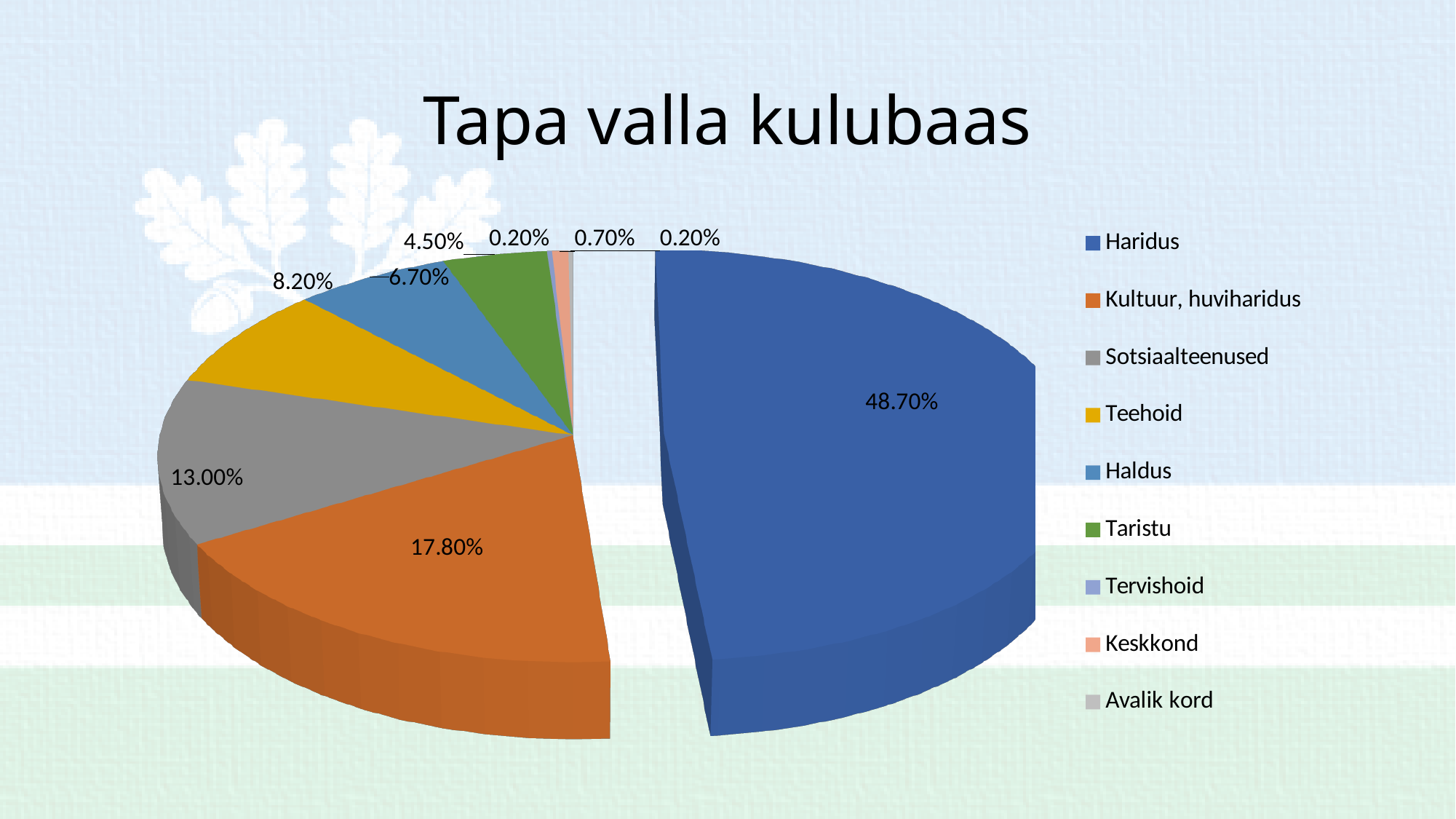
What is the value shown for Kultuur, huviharidus? 17.80% What colour is the Taristu slice? green What is the value shown for Teehoid? 8.20% What kind of chart is shown on the slide? pie chart What share of the pie does Haridus have? 48.70% What is the difference between the values for Haridus and Kultuur, huviharidus? 30.90% What is the value shown for Sotsiaalteenused? 13.00% Which category has the largest slice of the pie? Haridus Which is larger, the value for Teehoid or the value for Haldus? Teehoid What is the value shown for Haldus? 6.70% What is the title of the chart? Tapa valla kulubaas How many categories does the legend list? 9